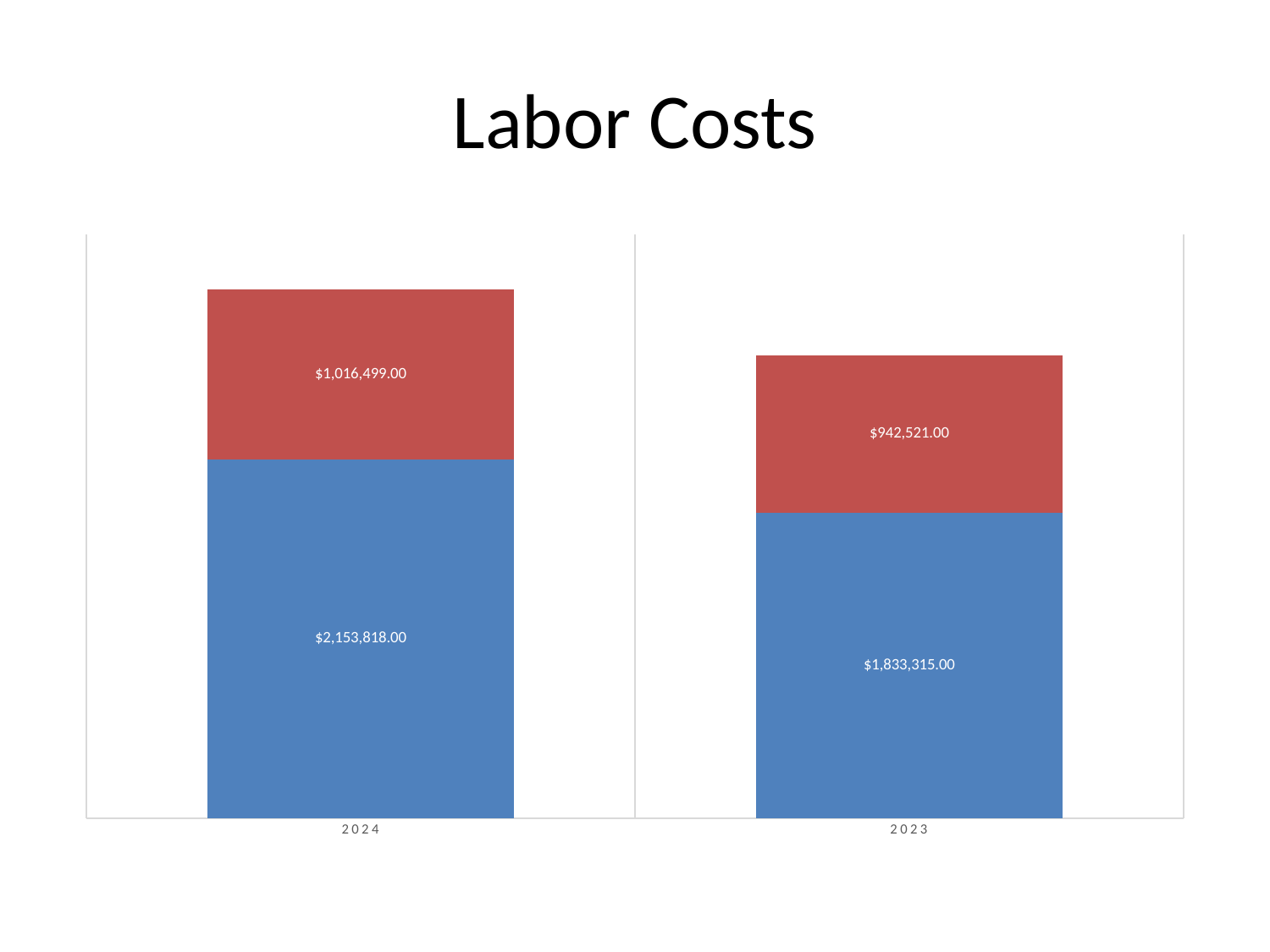
What is the value of the red segment for 2023? $942,521.00 What is the value of the blue segment for 2023? $1,833,315.00 Which year has the higher total labor cost? 2024 What is the total of the stacked bar for 2024? $3,170,317.00 What is the difference between the red segment values for 2024 and 2023? $73,978.00 What is the value of the red segment for 2024? $1,016,499.00 What is the difference between the blue segment values for 2024 and 2023? $320,503.00 What is the total of the stacked bar for 2023? $2,775,836.00 What is the value of the blue segment for 2024? $2,153,818.00 Which year has the larger blue segment, 2024 or 2023? 2024 How many categories are shown on the x axis? 2 What kind of chart is shown on the slide? Stacked bar chart